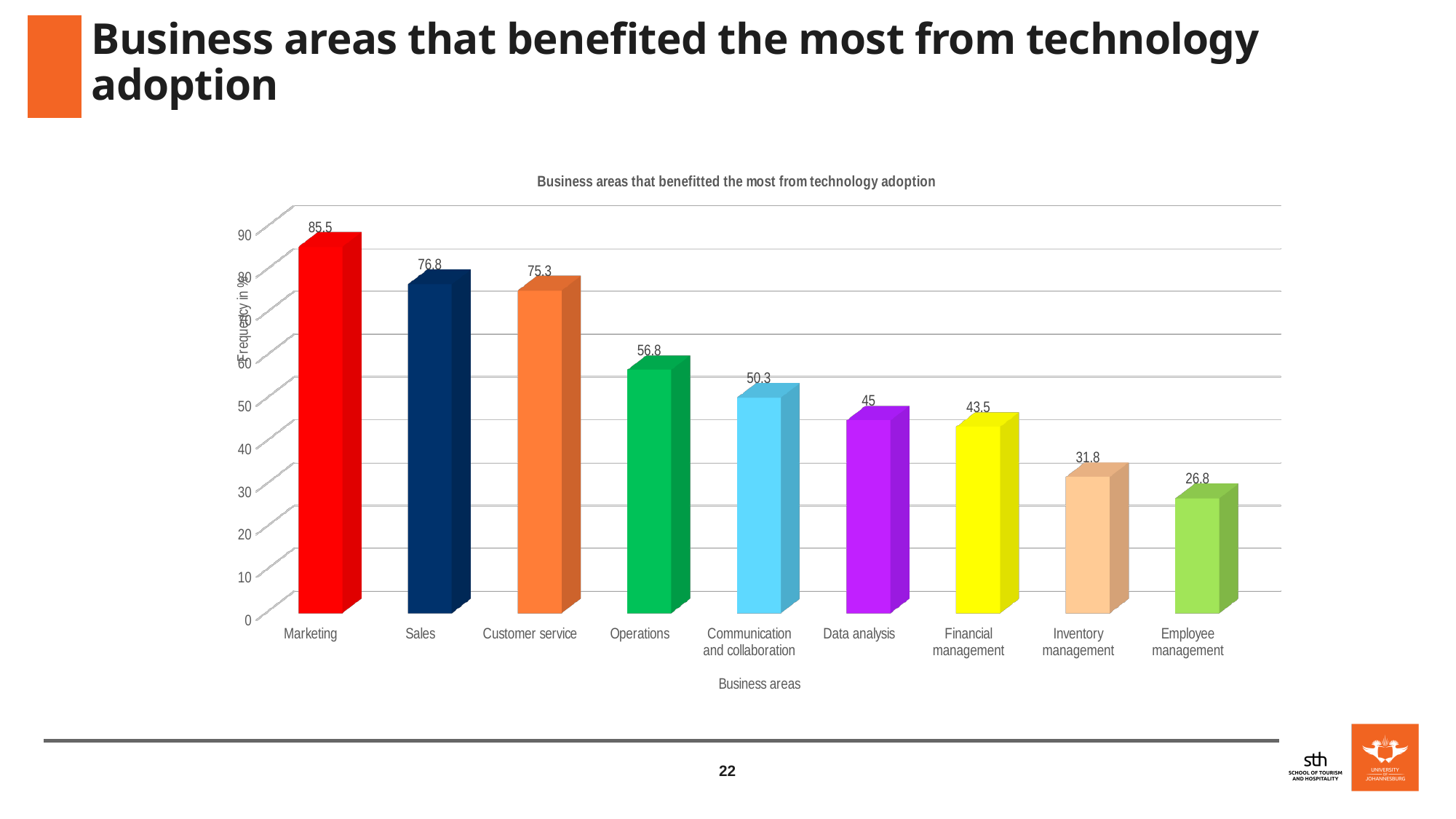
What is the label of the vertical axis? Frequency in % Which business area has the lowest value? Employee management Which business area has the highest value? Marketing What is the difference between the values for Operations and Data analysis? 11.8 Is the value for Operations greater or less than 50? greater What is the difference between the values for Sales and Customer service? 1.5 What is the value for Communication and collaboration? 50.3 Which is larger, the value for Financial management or the value for Data analysis? Data analysis How many business areas are shown on the chart? 9 What is the value for Inventory management? 31.8 What kind of chart is shown on the slide? bar chart What is the value for Marketing? 85.5